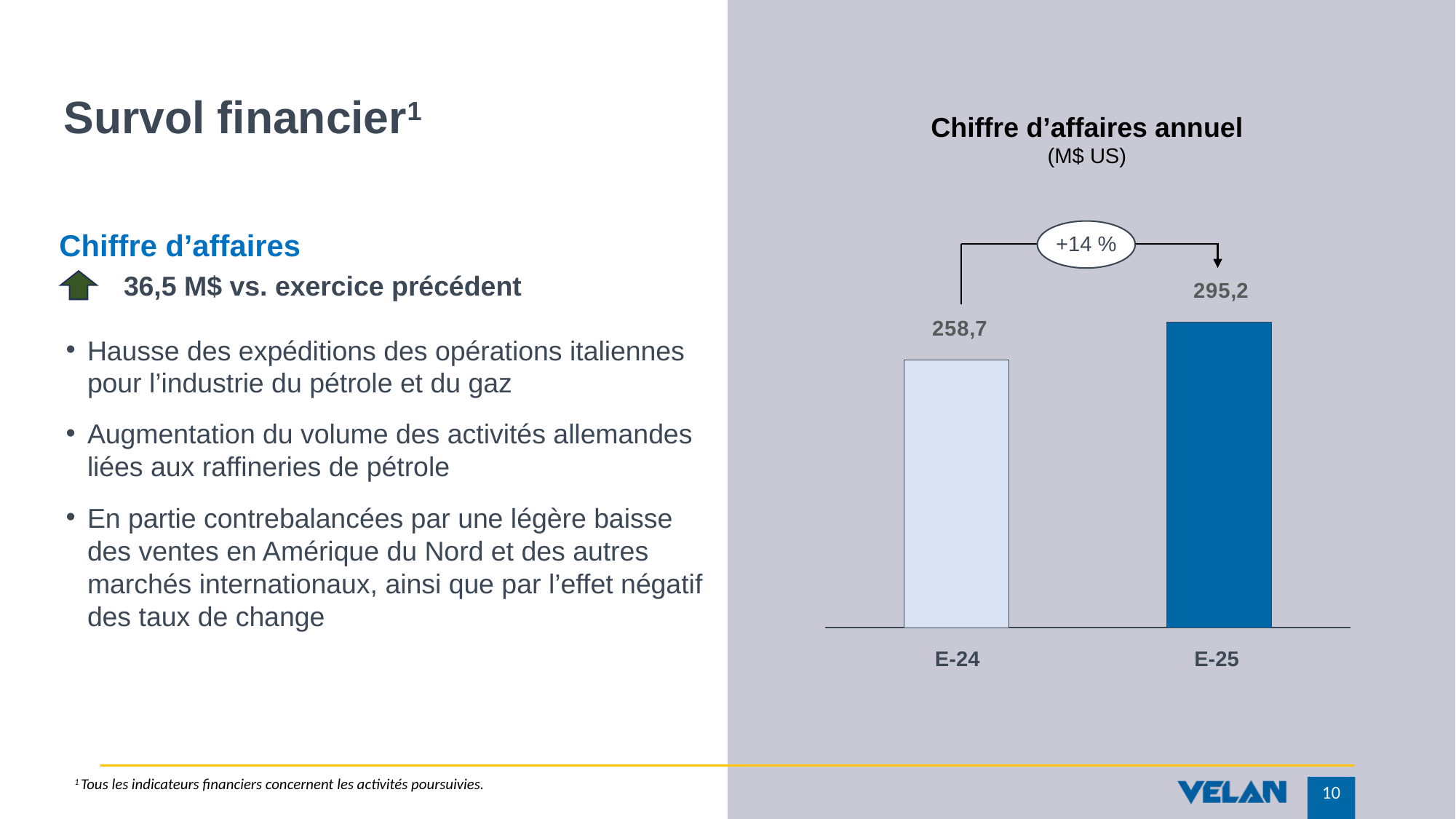
Do the values rise or fall from E-24 to E-25 in the 'Chiffre d'affaires annuel' chart? Rise What is the value for E-24 in the 'Chiffre d'affaires annuel' chart? 258,7 Which category has the lowest value in the 'Chiffre d'affaires annuel' chart? E-24 What kind of chart is the 'Chiffre d'affaires annuel' chart? Bar chart What is the difference between the E-25 and E-24 values in the 'Chiffre d'affaires annuel' chart? 36,5 What unit is indicated under the title of the 'Chiffre d'affaires annuel' chart? M$ US How many categories are shown in the 'Chiffre d'affaires annuel' chart? 2 What is the value for E-25 in the 'Chiffre d'affaires annuel' chart? 295,2 What percentage change is shown between E-24 and E-25 in the 'Chiffre d'affaires annuel' chart? +14 % Which category has the highest value in the 'Chiffre d'affaires annuel' chart? E-25 Which is larger in the 'Chiffre d'affaires annuel' chart, E-24 or E-25? E-25